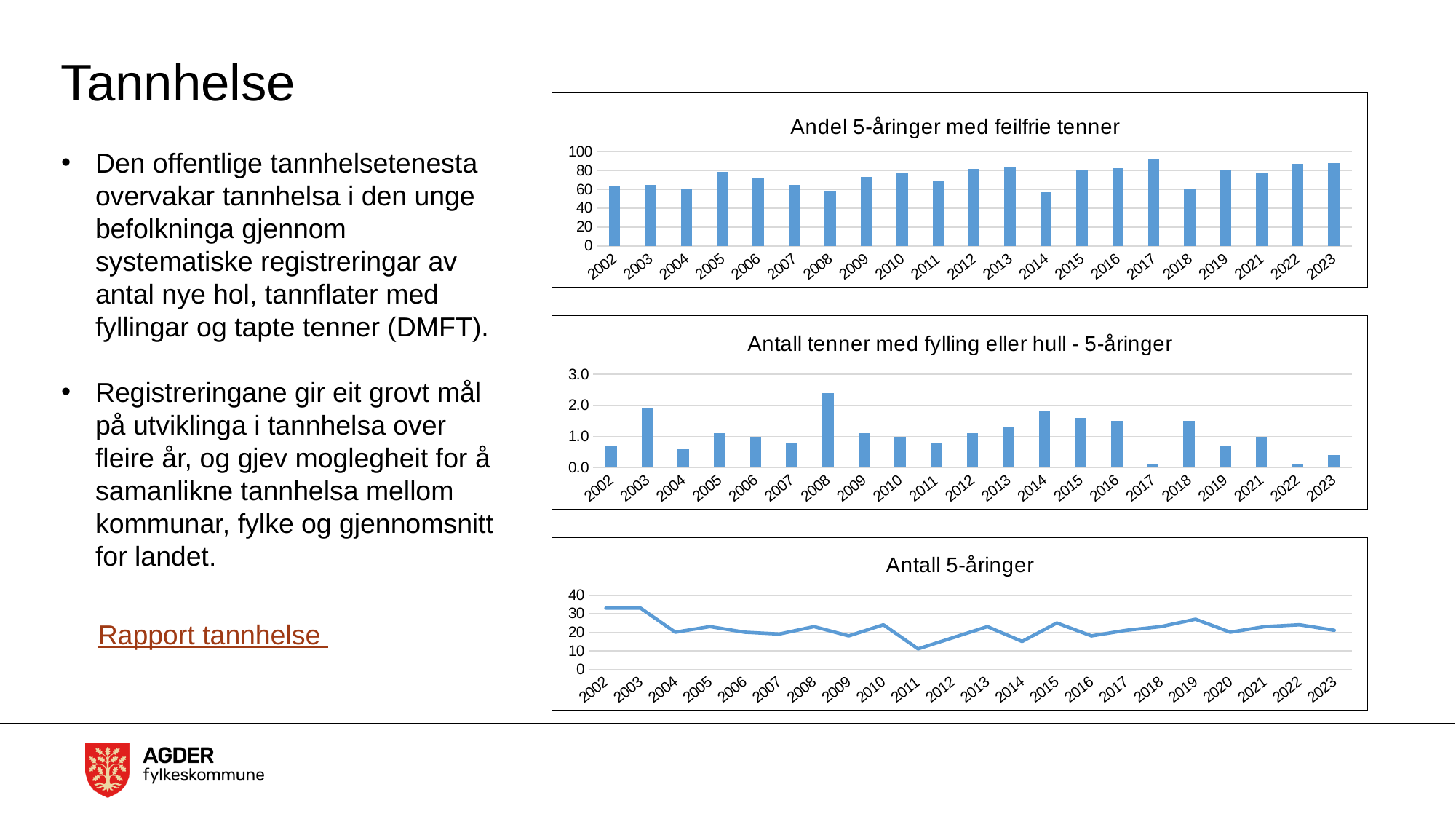
In the 'Antall 5-åringer' chart, which year has the lowest value? 2011 In the 'Antall tenner med fylling eller hull - 5-åringer' chart, is the value for 2008 greater or less than 2.0? greater What kind of chart is the 'Andel 5-åringer med feilfrie tenner' chart? bar chart In the 'Antall tenner med fylling eller hull - 5-åringer' chart, which is larger, the value for 2008 or the value for 2003? 2008 In the 'Andel 5-åringer med feilfrie tenner' chart, is the value for 2017 greater or less than 80? greater What kind of chart is the 'Antall 5-åringer' chart? line chart In the 'Andel 5-åringer med feilfrie tenner' chart, is the value for 2014 greater or less than 60? less In the 'Antall tenner med fylling eller hull - 5-åringer' chart, which year has the highest value? 2008 In the 'Andel 5-åringer med feilfrie tenner' chart, which year has the highest value? 2017 How many years are plotted in the 'Andel 5-åringer med feilfrie tenner' chart? 21